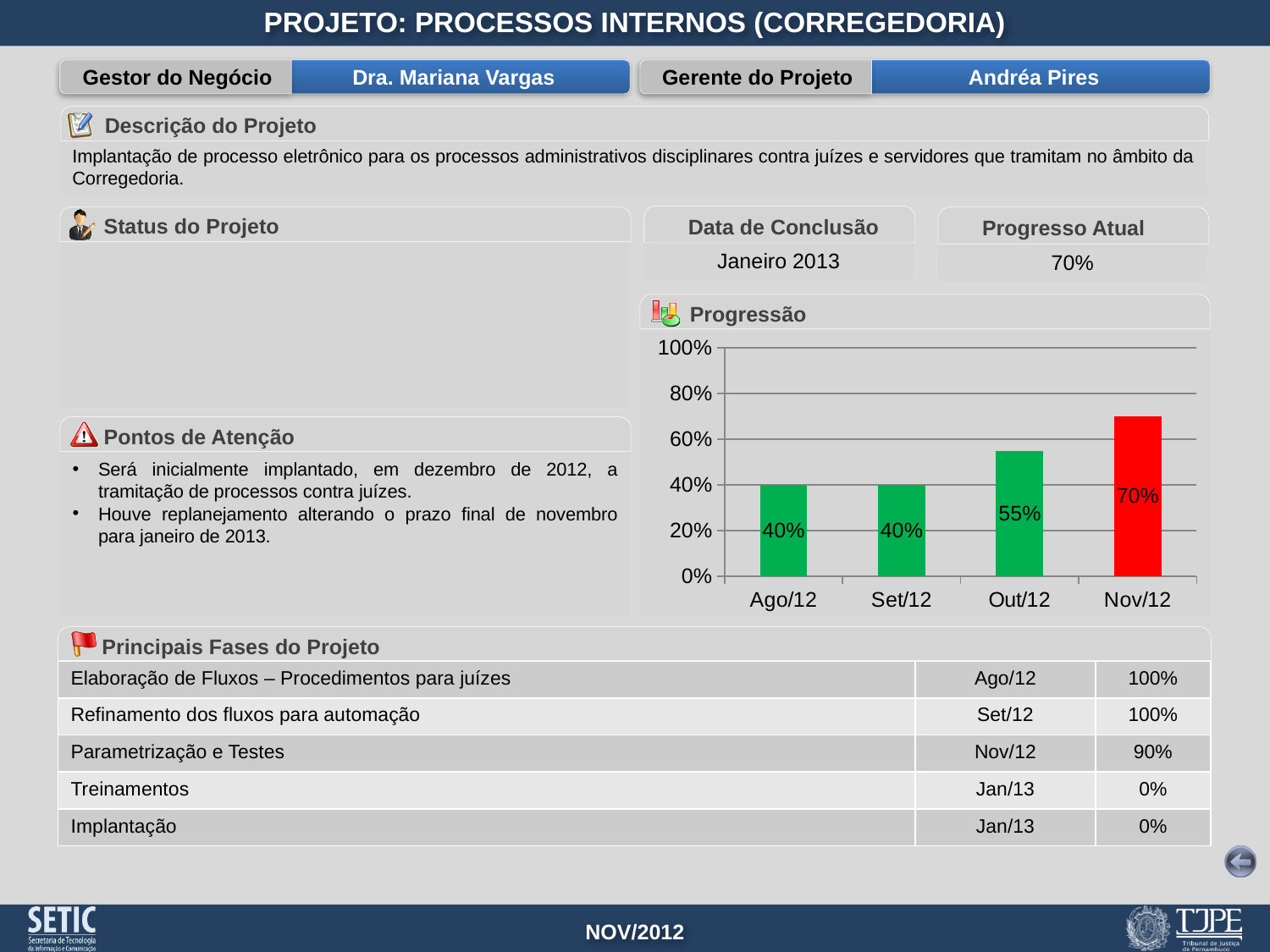
What is the value for Out/12 in the Progressão chart? 55% What is the value for Ago/12 in the Progressão chart? 40% How many months are shown on the x axis of the Progressão chart? 4 Do the values in the Progressão chart rise or fall from Ago/12 to Nov/12? rise What kind of chart is the Progressão chart? bar chart Which month has the highest value in the Progressão chart? Nov/12 What is the value for Nov/12 in the Progressão chart? 70% Is the value for Nov/12 in the Progressão chart greater or less than 60%? greater What is the difference between the values for Nov/12 and Out/12 in the Progressão chart? 15% What is the difference between the values for Out/12 and Set/12 in the Progressão chart? 15% What colour is the Nov/12 bar in the Progressão chart? red Which is larger in the Progressão chart, the value for Out/12 or the value for Set/12? Out/12